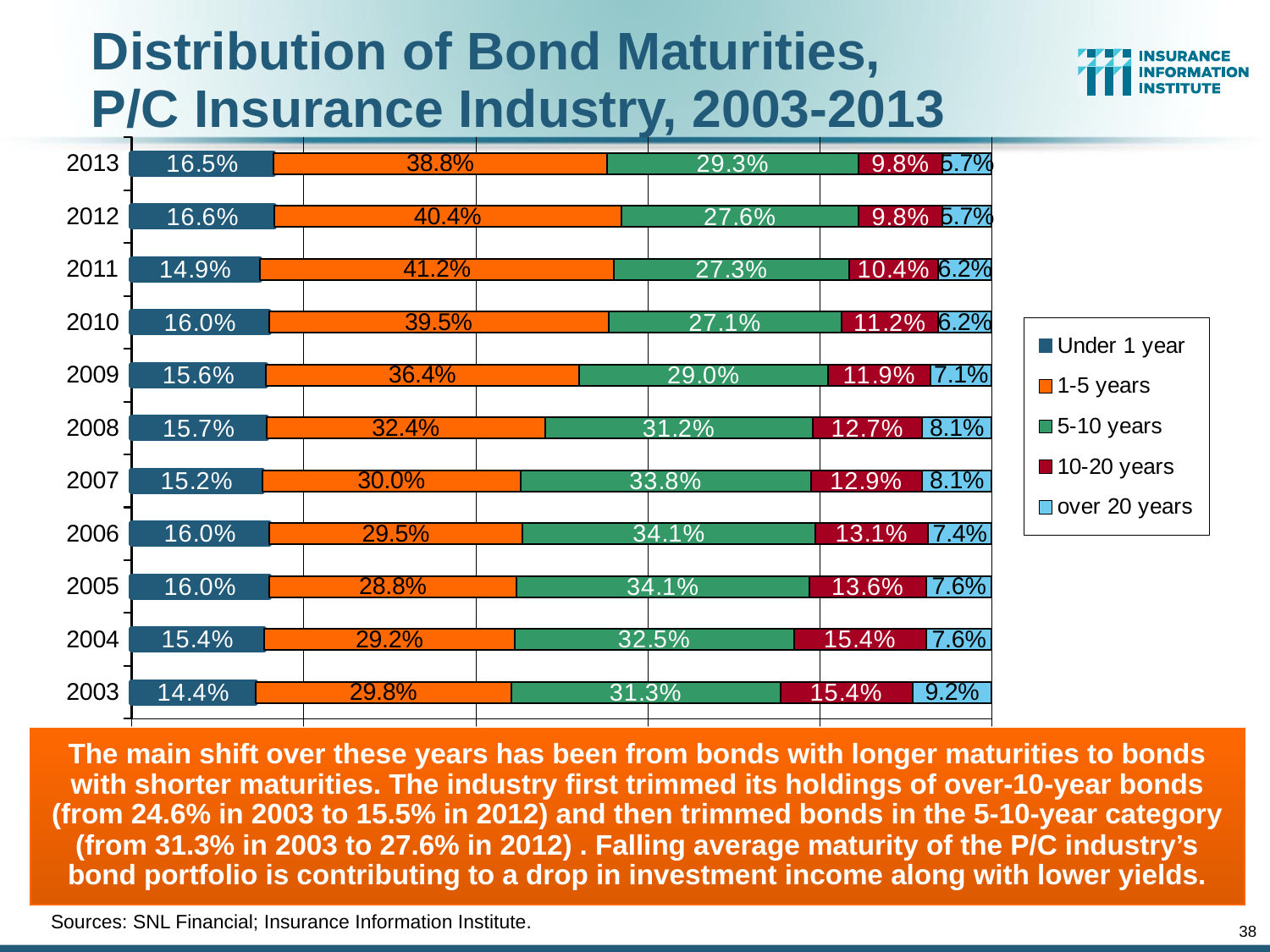
What kind of chart is shown on the slide? Stacked bar chart How many series does the legend list? 5 Which year has the lowest share of bonds in the Under 1 year category? 2003 Did the share of bonds with 10-20 year maturities rise or fall from 2003 to 2013? Fall By how many percentage points did the 1-5 years share in 2013 exceed the 1-5 years share in 2003? 9.0 percentage points Which year has the highest share of bonds in the 1-5 years category? 2011 What share of bonds had maturities of over 20 years in 2003? 9.2% How many years are shown on the chart? 11 What share of bonds had maturities of 10-20 years in 2009? 11.9% What share of bonds had maturities of 1-5 years in 2011? 41.2% In 2008, which was larger: the 1-5 years share or the 5-10 years share? 1-5 years What colour represents the 1-5 years category in the chart? Orange